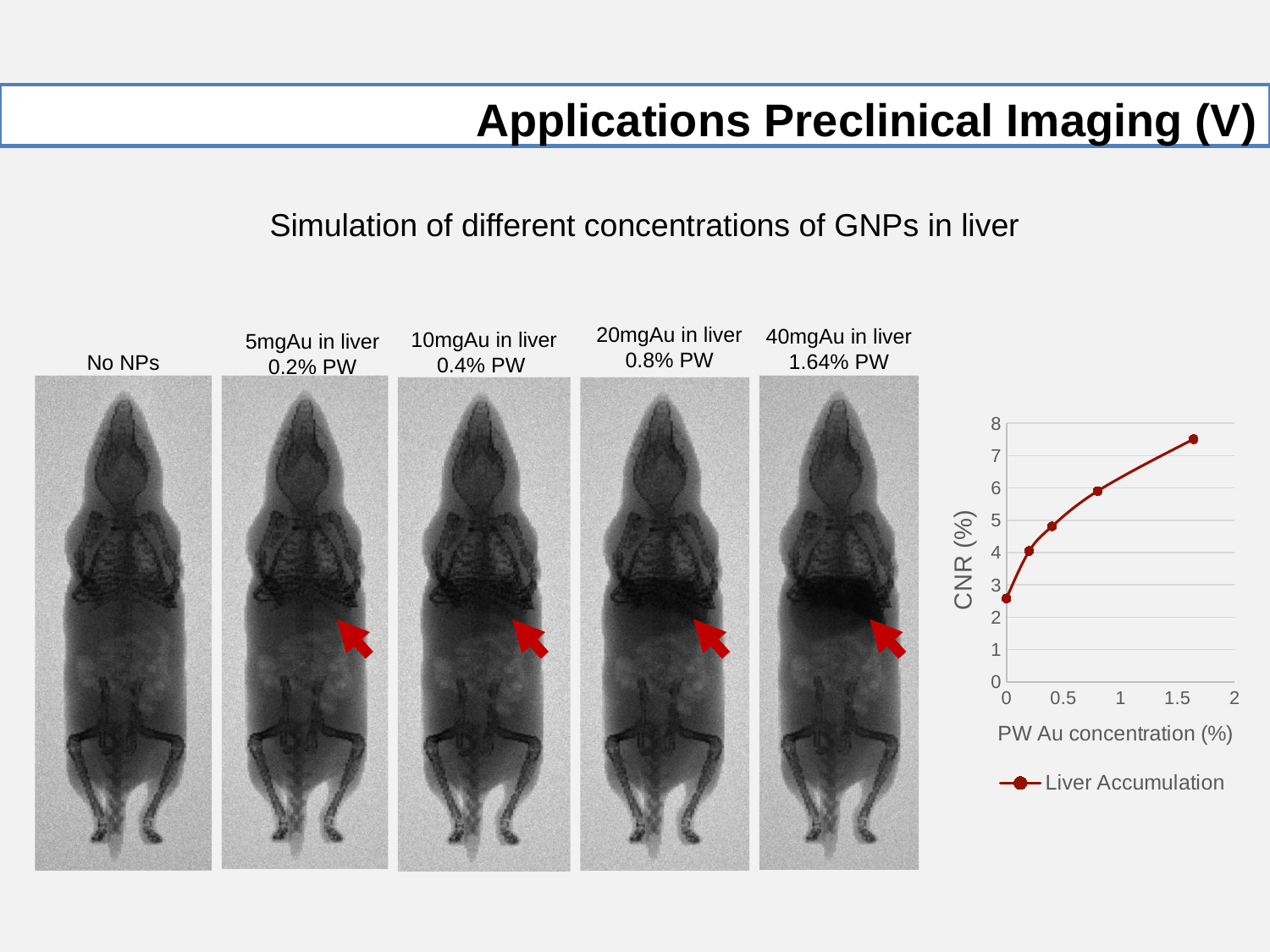
What is the label of the y axis of the chart? CNR (%) How many series does the chart legend list? 1 At which PW Au concentration is the CNR lowest? 0 Is the CNR value at the highest plotted PW Au concentration greater or less than 7? greater Which plotted point has the highest CNR: the one at PW Au concentration 0 or the one at about 1.64? the one at about 1.64 How many data points are plotted on the Liver Accumulation line? 5 Does CNR rise or fall as PW Au concentration increases along the x axis? rise What is the name of the series shown in the chart legend? Liver Accumulation What kind of chart is shown on the right of the slide? line chart Is the CNR value at a PW Au concentration of 0 greater or less than 3? less Is the CNR value at a PW Au concentration of 0.8 greater or less than 5? greater